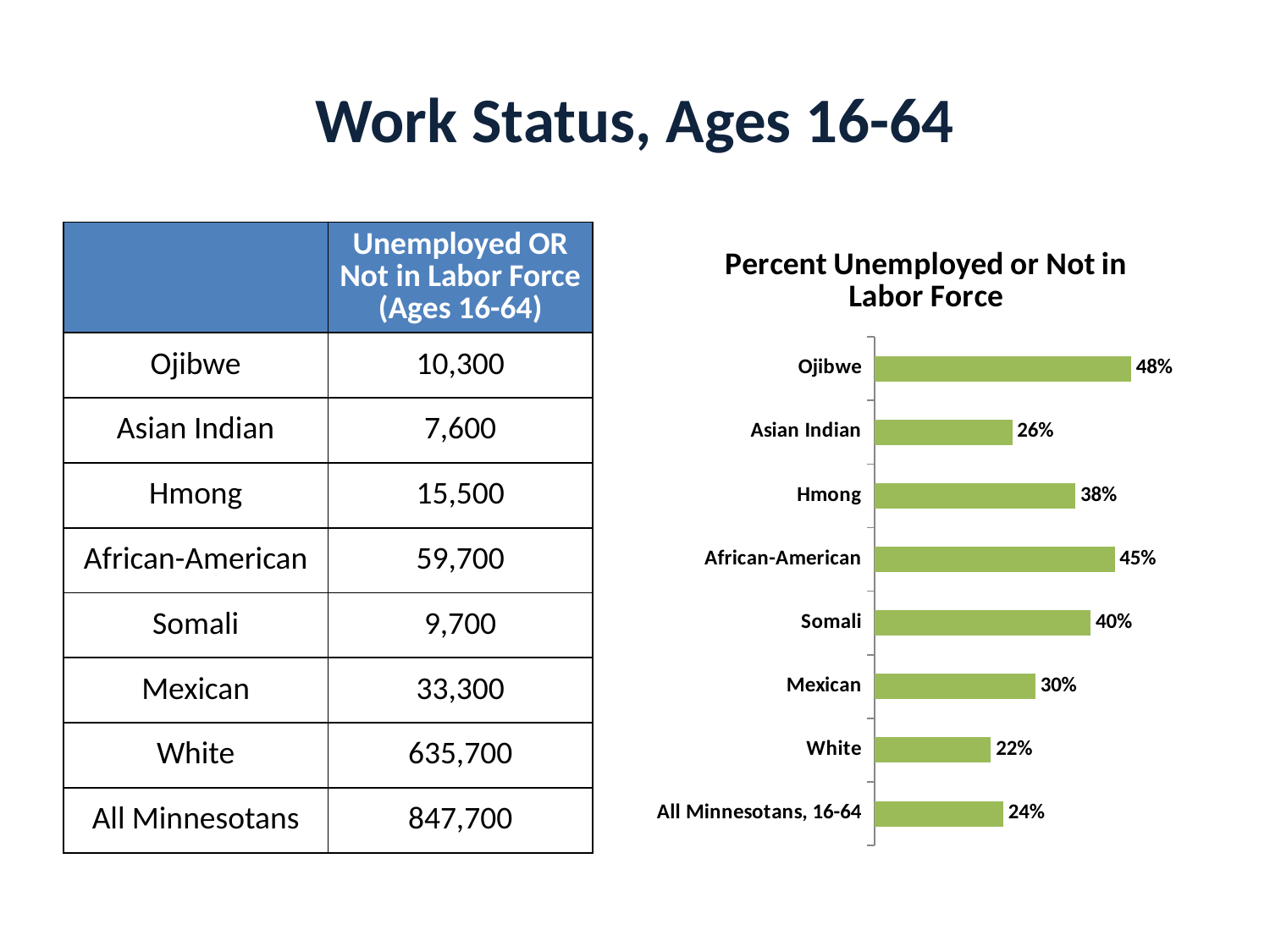
What is the value for Ojibwe in the chart? 48% What is the value for Asian Indian in the chart? 26% What colour are the bars in the chart? Green What is the value for All Minnesotans, 16-64 in the chart? 24% Which category has the highest value in the chart? Ojibwe What is the title of the chart? Percent Unemployed or Not in Labor Force What is the difference between the values for Ojibwe and White in the chart? 26% Which is larger in the chart, the value for Hmong or the value for Mexican? Hmong Which category has the lowest value in the chart? White What kind of chart is shown on the slide? Bar chart How many categories are shown in the chart? 8 What is the difference between the values for African-American and Somali in the chart? 5%